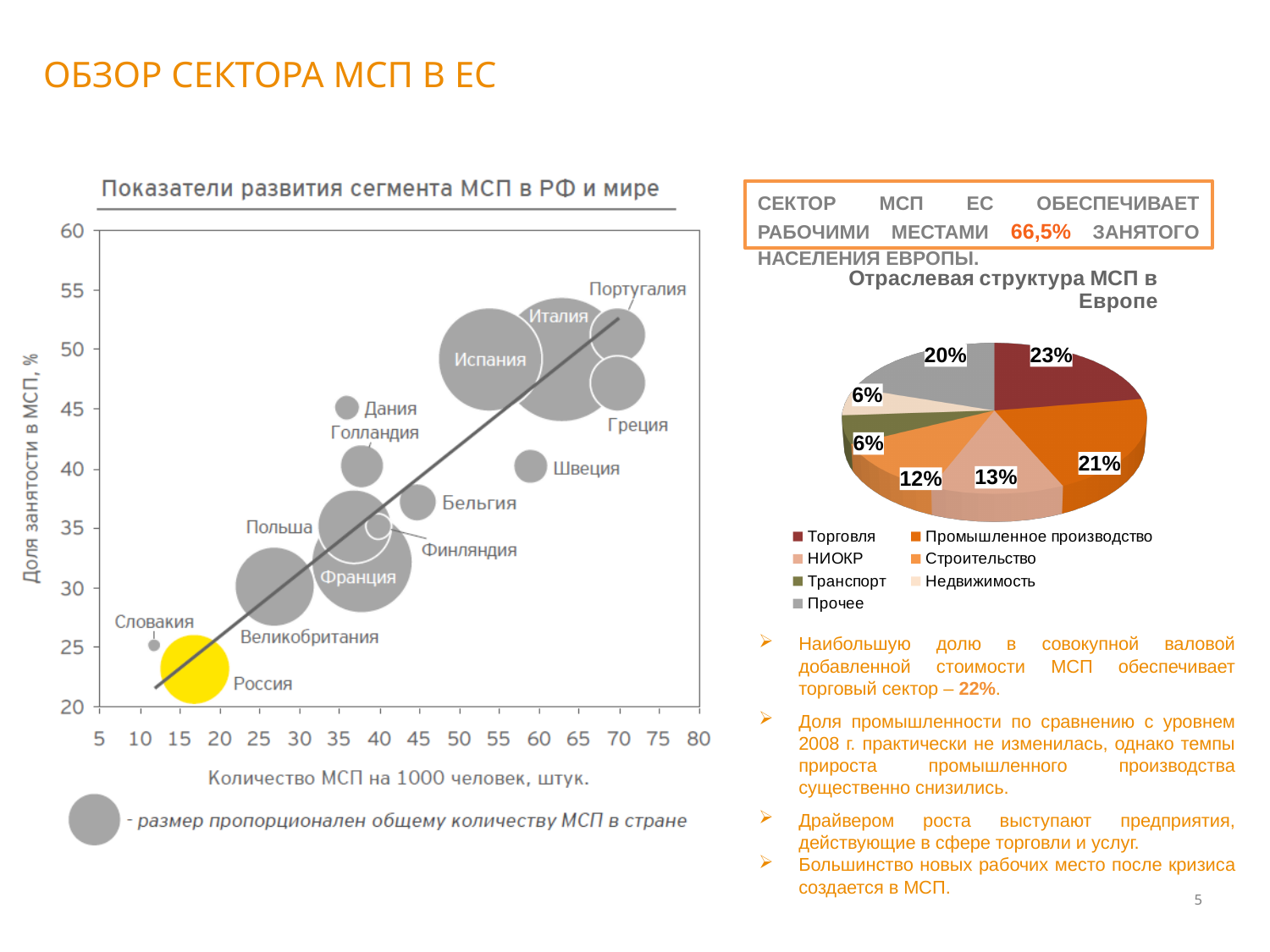
In the chart 'Показатели развития сегмента МСП в РФ и мире', is the share of employment in SMEs for Россия greater or less than 30%? less In the pie chart 'Отраслевая структура МСП в Европе', what share does Промышленное производство have? 21% In the pie chart 'Отраслевая структура МСП в Европе', which is larger: Прочее or Промышленное производство? Промышленное производство How many entries does the legend of the pie chart 'Отраслевая структура МСП в Европе' list? 7 In the chart 'Показатели развития сегмента МСП в РФ и мире', how many countries are plotted? 14 In the pie chart 'Отраслевая структура МСП в Европе', what share does НИОКР have? 13% In the pie chart 'Отраслевая структура МСП в Европе', which sector has the largest share? Торговля In the chart 'Показатели развития сегмента МСП в РФ и мире', does the share of employment in SMEs generally rise or fall as the number of SMEs per 1000 people increases? Rise In the pie chart 'Отраслевая структура МСП в Европе', what is the difference between the shares of Торговля and Строительство? 11% What kind of chart is 'Показатели развития сегмента МСП в РФ и мире'? Bubble chart In the pie chart 'Отраслевая структура МСП в Европе', what share does Торговля have? 23% In the chart 'Показатели развития сегмента МСП в РФ и мире', is the share of employment in SMEs for Испания greater or less than 45%? greater